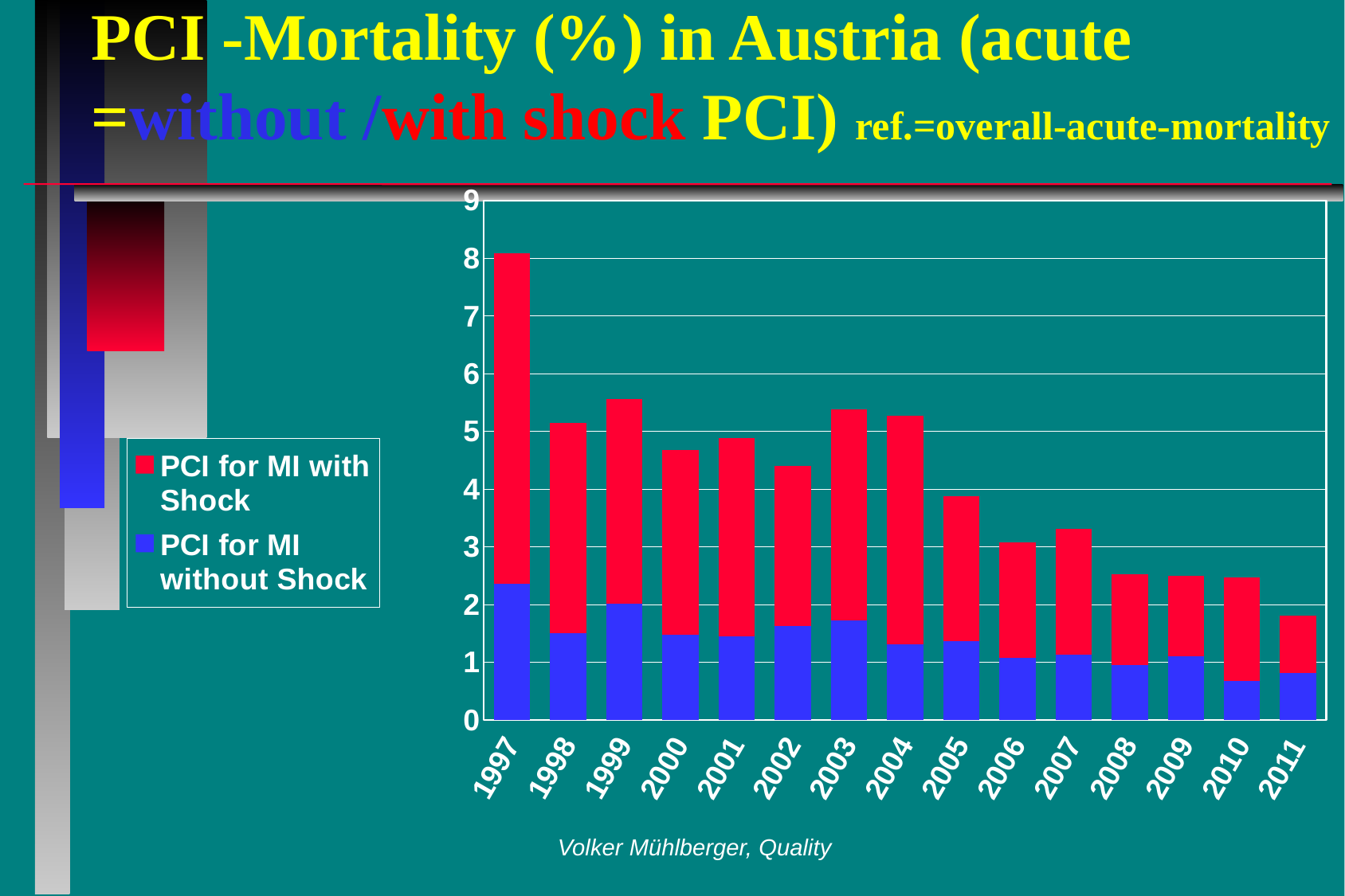
Which year has the lowest total bar in the chart? 2011 Which year has the highest total bar in the chart? 1997 What kind of chart is shown on the slide? stacked bar chart Do the total bar heights generally rise or fall from 1997 to 2011? fall How many series does the chart's legend list? 2 How many years are shown on the x axis of the chart? 15 Is the total bar for 2008 greater or less than 3? less Is the total bar for 2011 greater or less than 2? less Which colour represents 'PCI for MI with Shock' in the chart? red Is the total bar for 2003 greater or less than 5? greater Which year has the larger total bar, 1997 or 1998? 1997